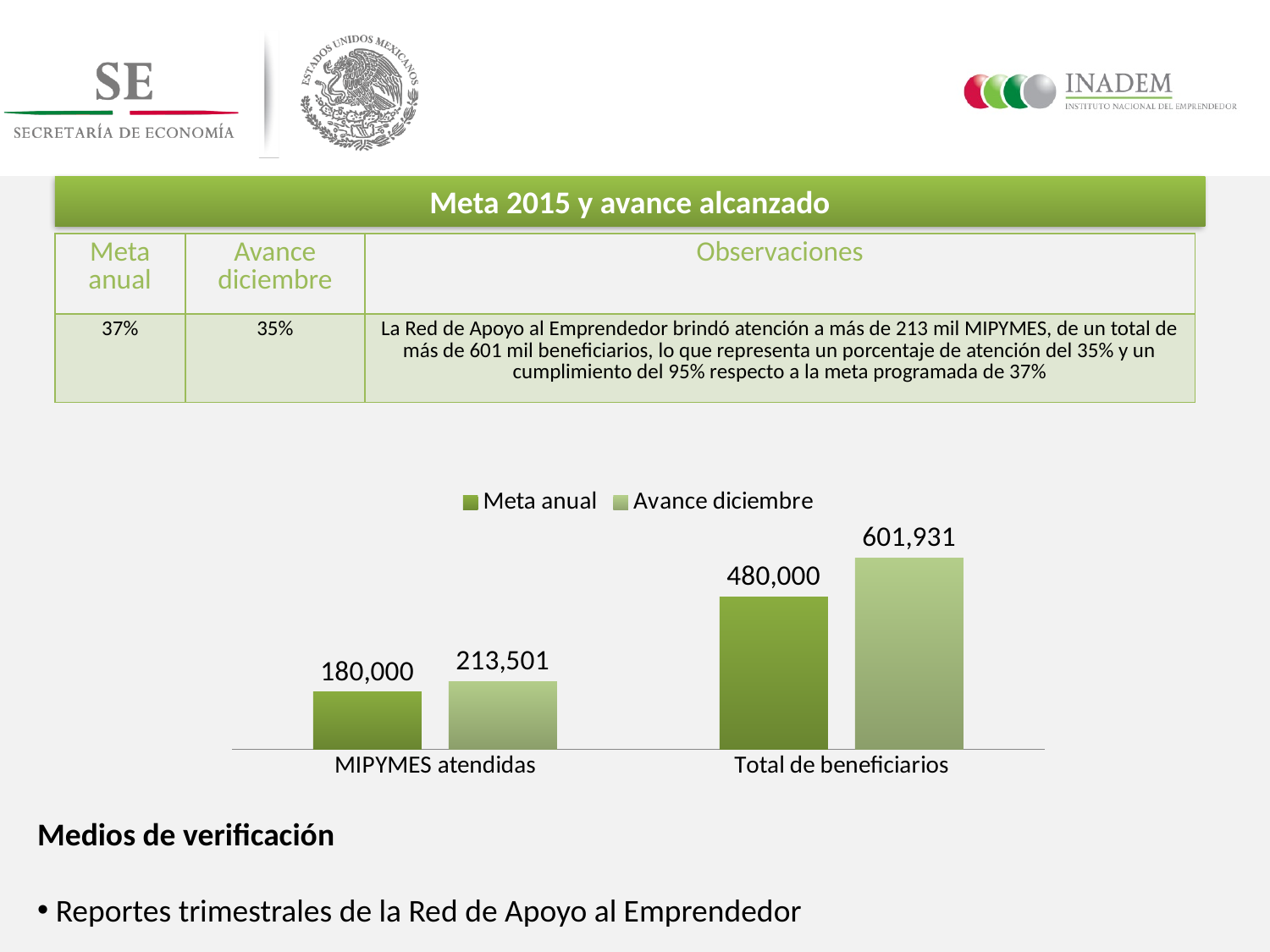
Which bar in the chart has the lowest value? Meta anual for MIPYMES atendidas What type of chart is shown on the slide? Bar chart What is the difference between Avance diciembre and Meta anual for MIPYMES atendidas? 33,501 How many categories are shown on the x axis of the chart? 2 What is the Meta anual value for Total de beneficiarios? 480,000 What is the Avance diciembre value for Total de beneficiarios? 601,931 How many series does the chart legend list? 2 What is the difference between Avance diciembre and Meta anual for Total de beneficiarios? 121,931 What is the Avance diciembre value for MIPYMES atendidas? 213,501 For MIPYMES atendidas, which is larger: Meta anual or Avance diciembre? Avance diciembre What is the Meta anual value for MIPYMES atendidas? 180,000 Which bar in the chart has the highest value? Avance diciembre for Total de beneficiarios